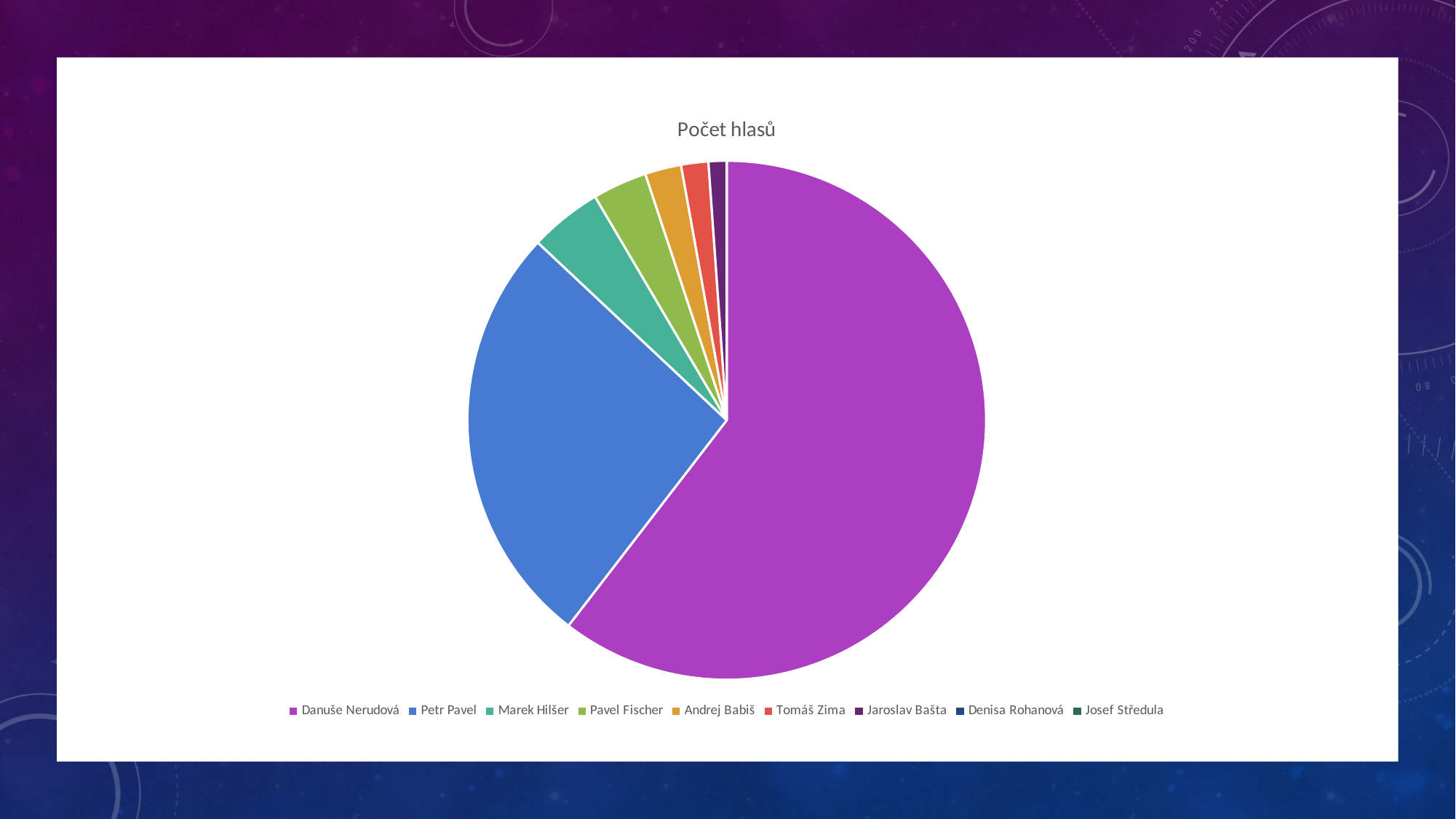
Which slice is larger, Marek Hilšer or Tomáš Zima? Marek Hilšer Which category has the largest slice of the pie? Danuše Nerudová How many categories does the legend of the chart list? 9 Which slice is larger, Andrej Babiš or Jaroslav Bašta? Andrej Babiš Which category has the second-largest slice of the pie? Petr Pavel Does the slice for Danuše Nerudová take up more or less than half of the pie? more What colour is the slice for Petr Pavel? blue Which slice is larger, Petr Pavel or Pavel Fischer? Petr Pavel What is the title of the chart? Počet hlasů What kind of chart is shown on the slide? pie chart